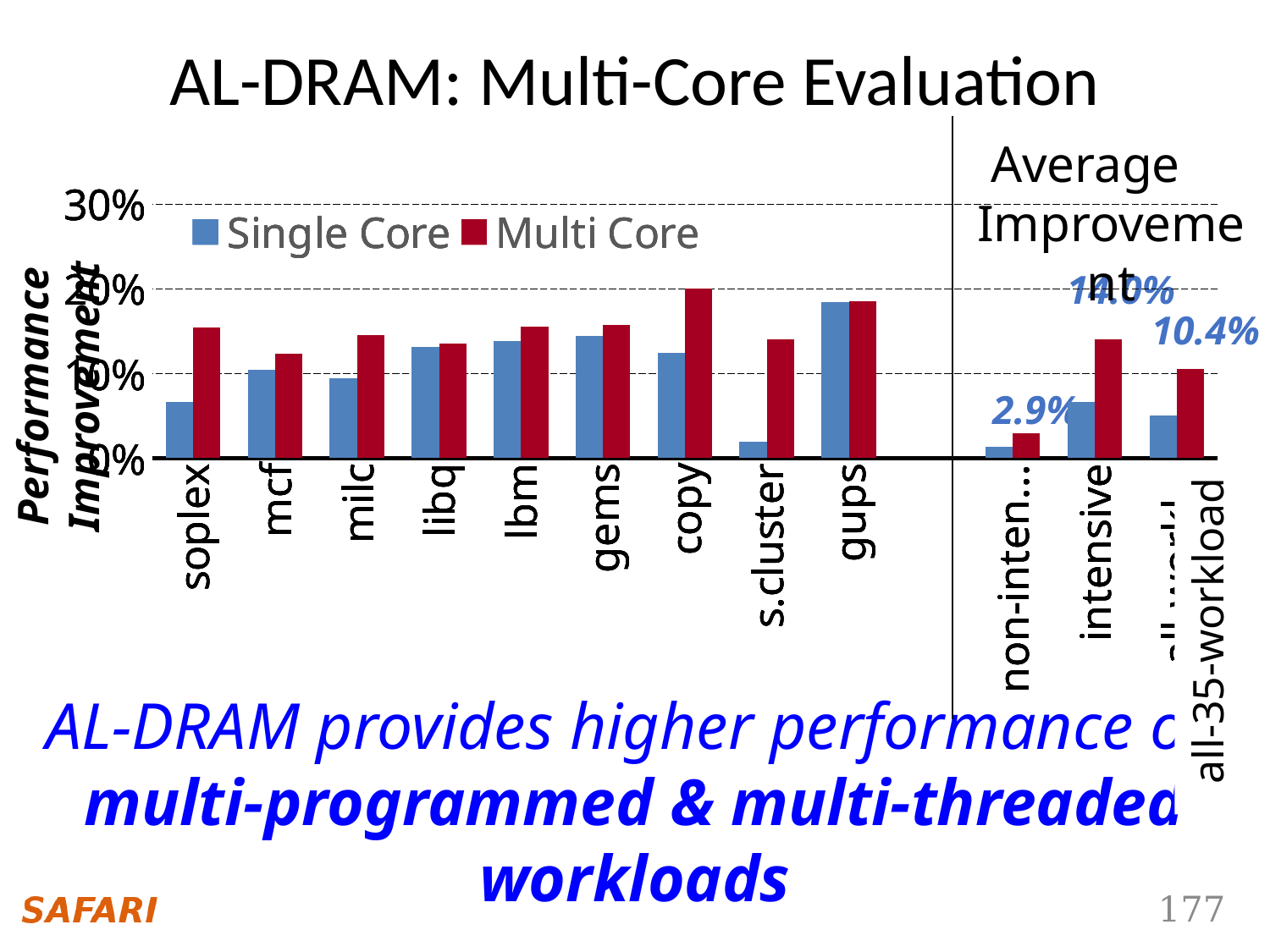
Among the individual benchmarks left of the divider, which has the highest Single Core value? gups Is the Single Core value for soplex greater or less than 10%? less What is the title of the slide containing the chart? AL-DRAM: Multi-Core Evaluation What kind of chart is shown on the slide? bar chart What is the labelled Multi Core performance improvement for the all-35-workload category? 10.4% How many series does the chart legend list? 2 What are the two series named in the chart legend? Single Core and Multi Core How many individual benchmarks are plotted to the left of the vertical divider line? 9 For copy, which is larger: the Single Core value or the Multi Core value? Multi Core What is the labelled Multi Core performance improvement for the non-intensive category? 2.9% Among the individual benchmarks left of the divider, which has the lowest Single Core value? s.cluster Is the Multi Core value for s.cluster greater or less than 10%? greater